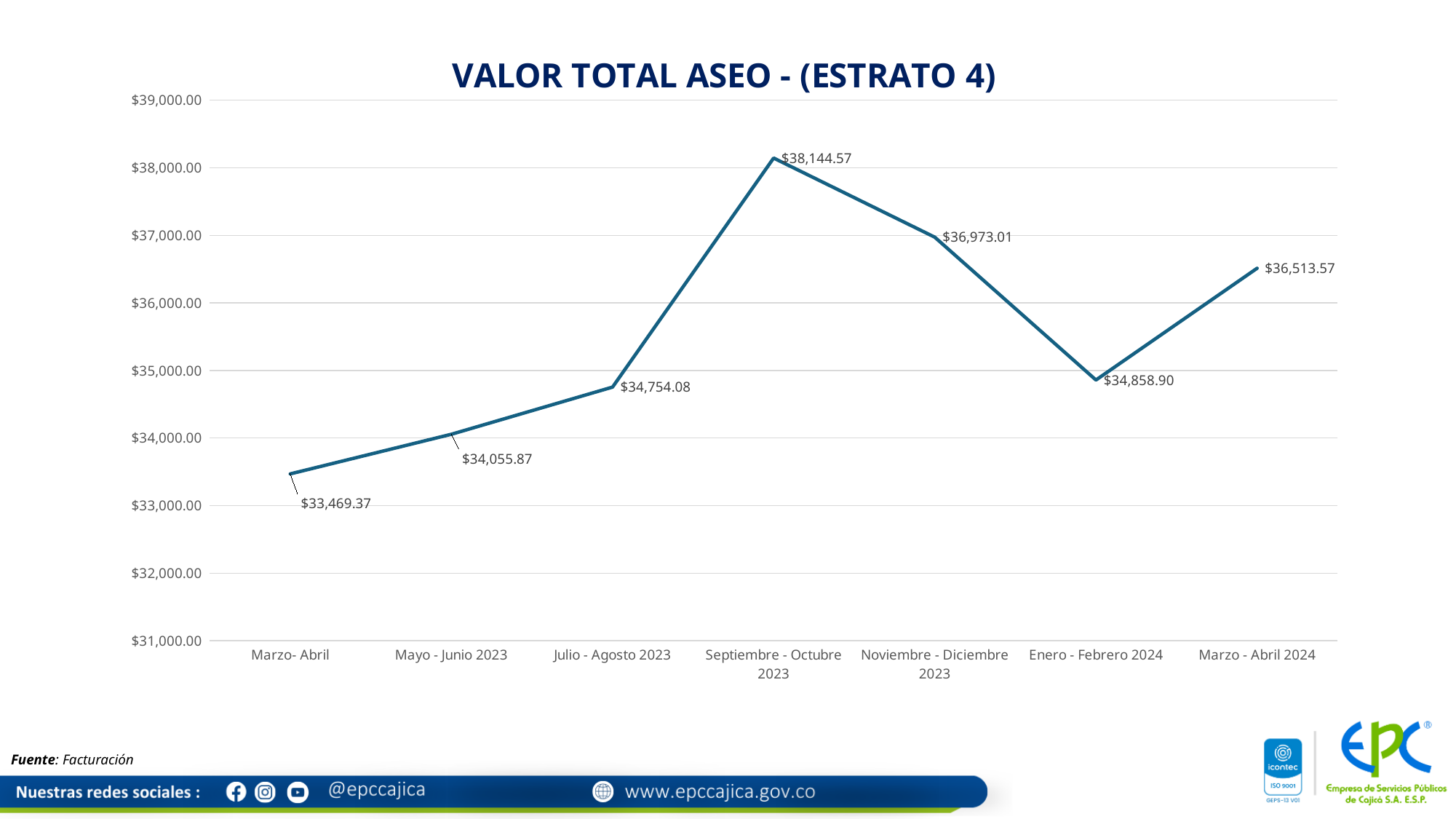
What is the value for Marzo - Abril 2024? $36,513.57 Which period has the highest value? Septiembre - Octubre 2023 What is the value for Enero - Febrero 2024? $34,858.90 What is the difference between the values for Marzo - Abril 2024 and Enero - Febrero 2024? $1,654.67 What is the difference between the values for Septiembre - Octubre 2023 and Noviembre - Diciembre 2023? $1,171.56 Which period has the lowest value? Marzo- Abril What is the title of the chart? VALOR TOTAL ASEO - (ESTRATO 4) What is the value for Septiembre - Octubre 2023? $38,144.57 How many periods are plotted on the chart? 7 What is the value for Marzo- Abril (the first point)? $33,469.37 What type of chart is shown on the slide? Line chart Which is larger, the value for Noviembre - Diciembre 2023 or the value for Marzo - Abril 2024? Noviembre - Diciembre 2023